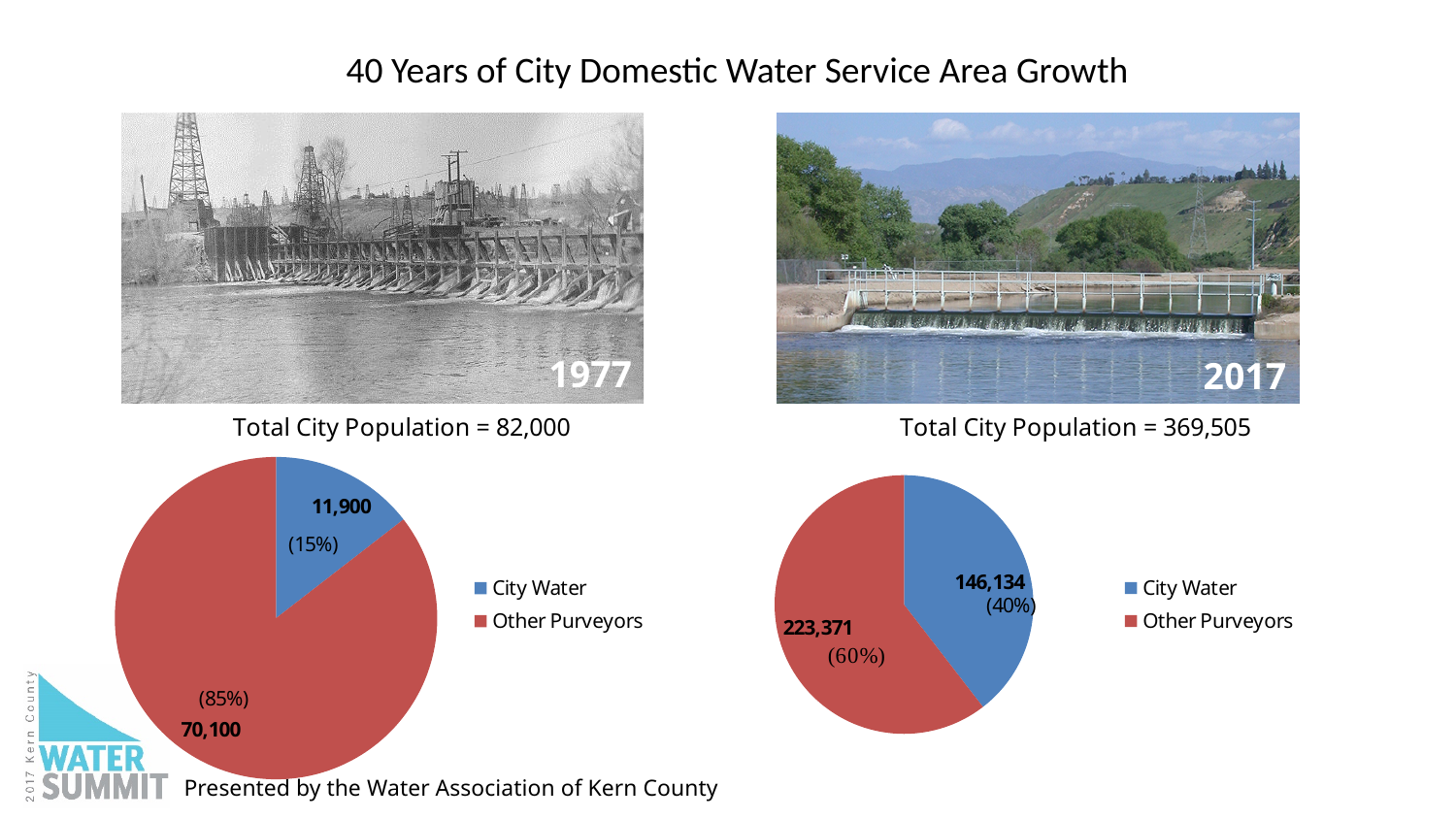
How many categories does the legend of the 1977 pie chart on the left list? 2 In the 2017 pie chart on the right, what is the difference between Other Purveyors and City Water? 77,237 In the 2017 pie chart on the right, what share of the pie does Other Purveyors represent? 60% In the 2017 pie chart on the right, which category is the largest? Other Purveyors In the 1977 pie chart on the left, what is the value for Other Purveyors? 70,100 In the 2017 pie chart on the right, what is the value for Other Purveyors? 223,371 In the 1977 pie chart on the left, what share of the pie does City Water represent? 15% What kind of chart is shown under the 2017 photo on the right? Pie chart In the 2017 pie chart on the right, what is the value for City Water? 146,134 In the 1977 pie chart on the left, which category is the smallest? City Water In the 1977 pie chart on the left, what is the value for City Water? 11,900 In the 1977 pie chart on the left, what is the difference between Other Purveyors and City Water? 58,200